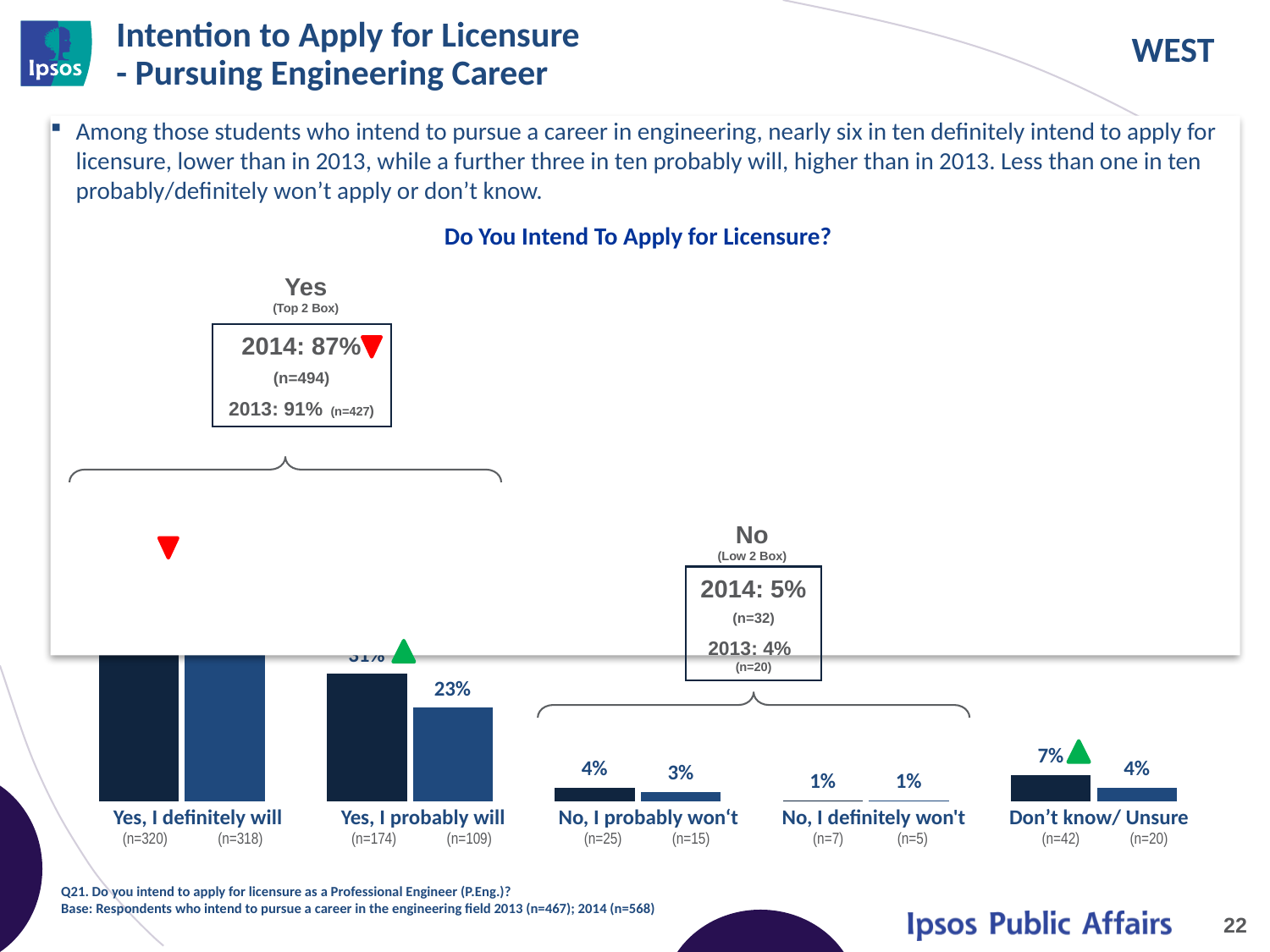
What is the value of the dark navy (left) bar for "Don't know/ Unsure"? 7% What is the value of the lighter blue (right) bar for "No, I probably won't"? 3% What kind of chart is shown on the slide? Bar chart Which category has the lowest values in the chart? No, I definitely won't What is the value of the lighter blue (right) bar for "Don't know/ Unsure"? 4% What value is shown for both bars in the "No, I definitely won't" category? 1% What is the difference between the dark navy bar and the lighter blue bar for "Don't know/ Unsure"? 3 percentage points How many response categories are shown along the x axis of the chart? 5 Which category has the tallest bars in the chart? Yes, I definitely will What is the title of the chart? Do You Intend To Apply for Licensure? What is the value of the lighter blue (right) bar for "Yes, I probably will"? 23% What is the value of the dark navy (left) bar for "No, I probably won't"? 4%